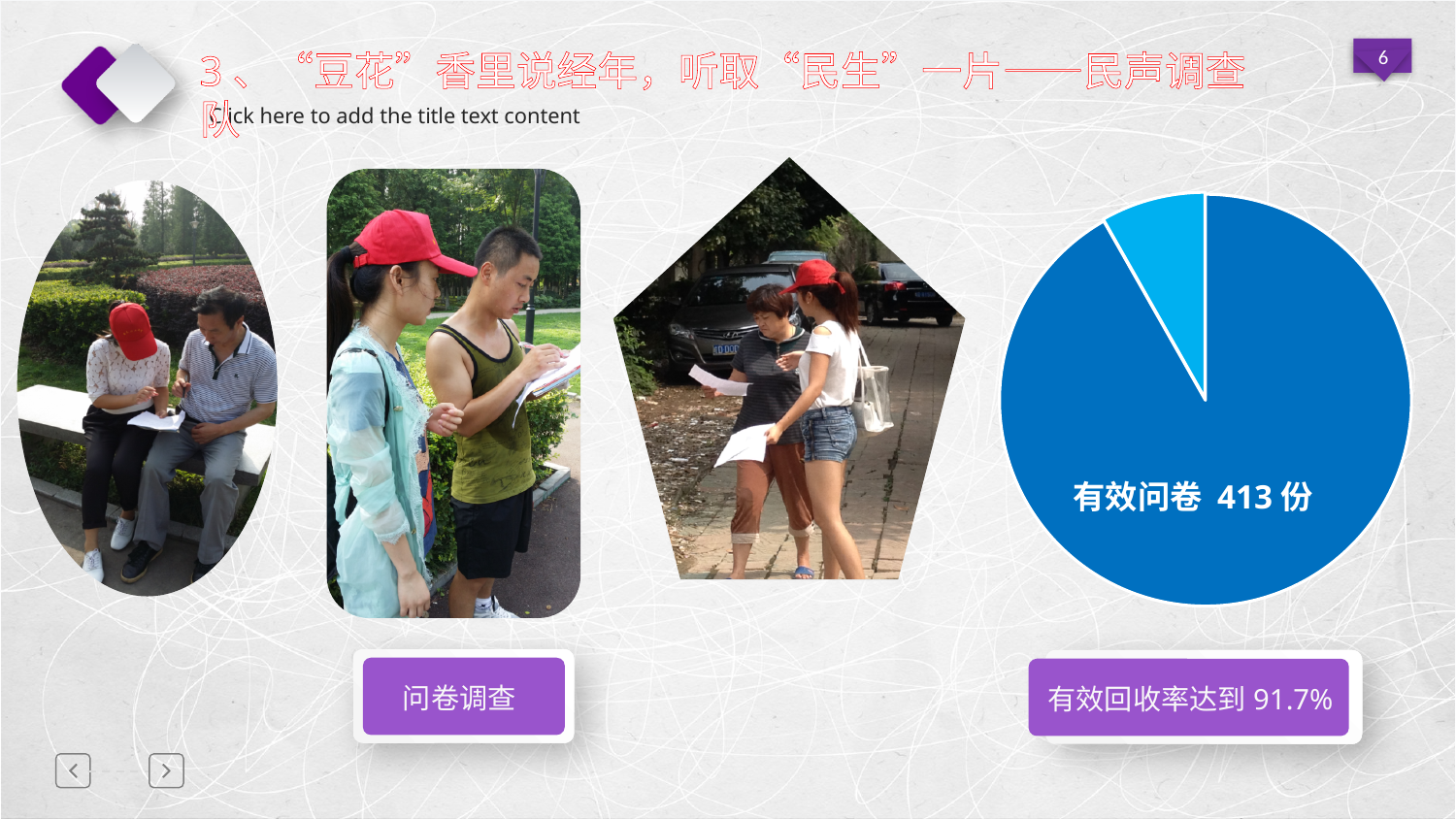
What text label is printed inside the large slice of the pie chart? 有效问卷 413 份 Is the large slice of the pie chart greater or less than 50% of the pie? greater Is the small light blue slice of the pie chart greater or less than 25% of the pie? less How many slices does the pie chart have? 2 According to the label on the pie chart, how many valid questionnaires (有效问卷) were collected? 413 份 Does the pie chart display a legend? No Which slice of the pie chart is larger, the dark blue one or the light blue one? dark blue What kind of chart is shown on the right side of the slide? pie chart What colour is the smaller slice of the pie chart? light blue According to the text below the pie chart, what is the effective recovery rate (有效回收率)? 91.7%